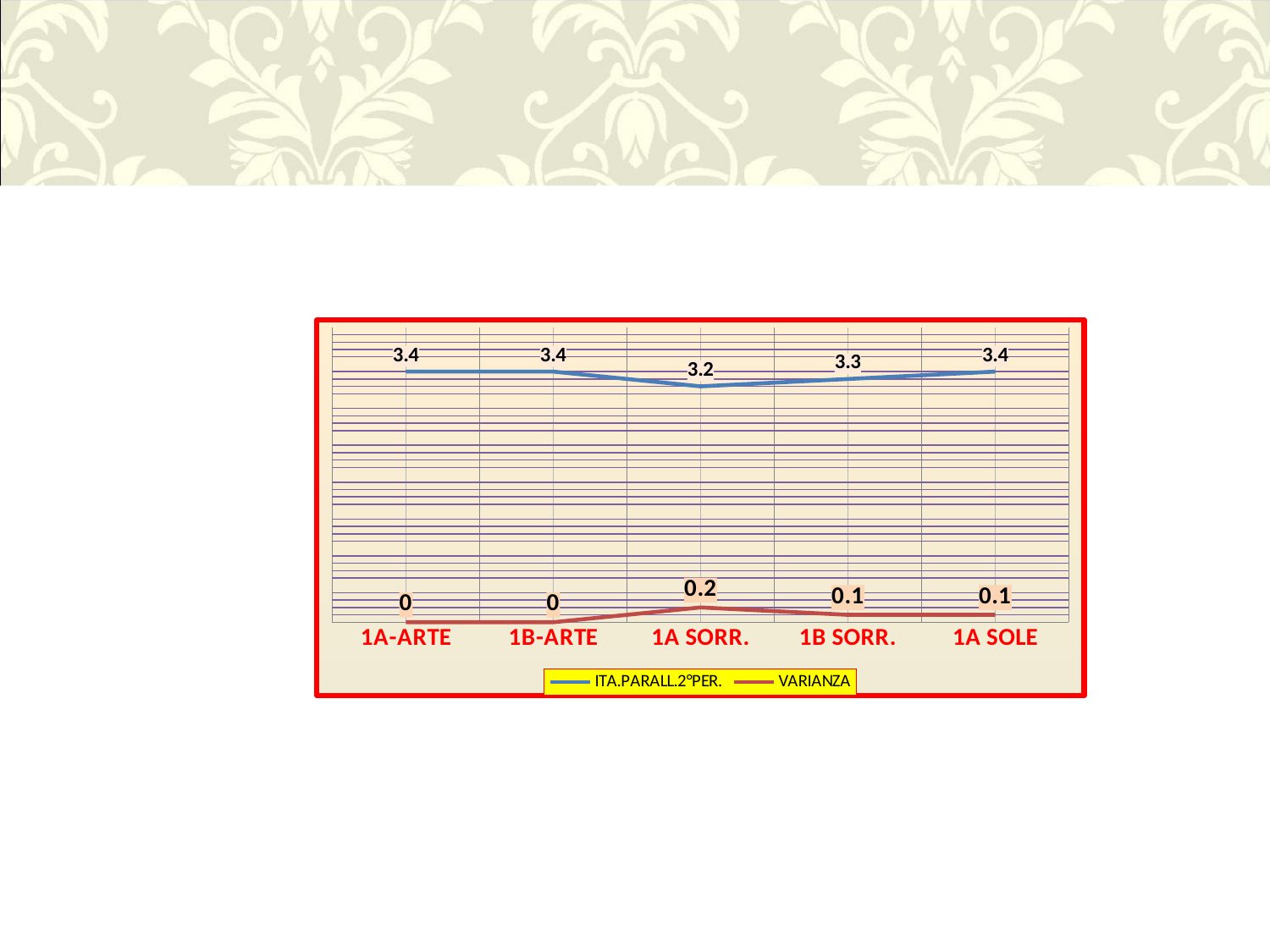
Which series is drawn in red? VARIANZA How many series does the legend list? 2 What is the VARIANZA value for 1A-ARTE? 0 How many categories are shown on the x axis? 5 What is the difference between the ITA.PARALL.2°PER. values for 1A-ARTE and 1A SORR.? 0.2 Which is larger, the ITA.PARALL.2°PER. value for 1B SORR. or for 1A SOLE? 1A SOLE What is the ITA.PARALL.2°PER. value for 1A SORR.? 3.2 Which category has the lowest ITA.PARALL.2°PER. value? 1A SORR. What is the ITA.PARALL.2°PER. value for 1B SORR.? 3.3 Which category has the highest VARIANZA value? 1A SORR. What kind of chart is shown on the slide? line chart What is the VARIANZA value for 1A SORR.? 0.2